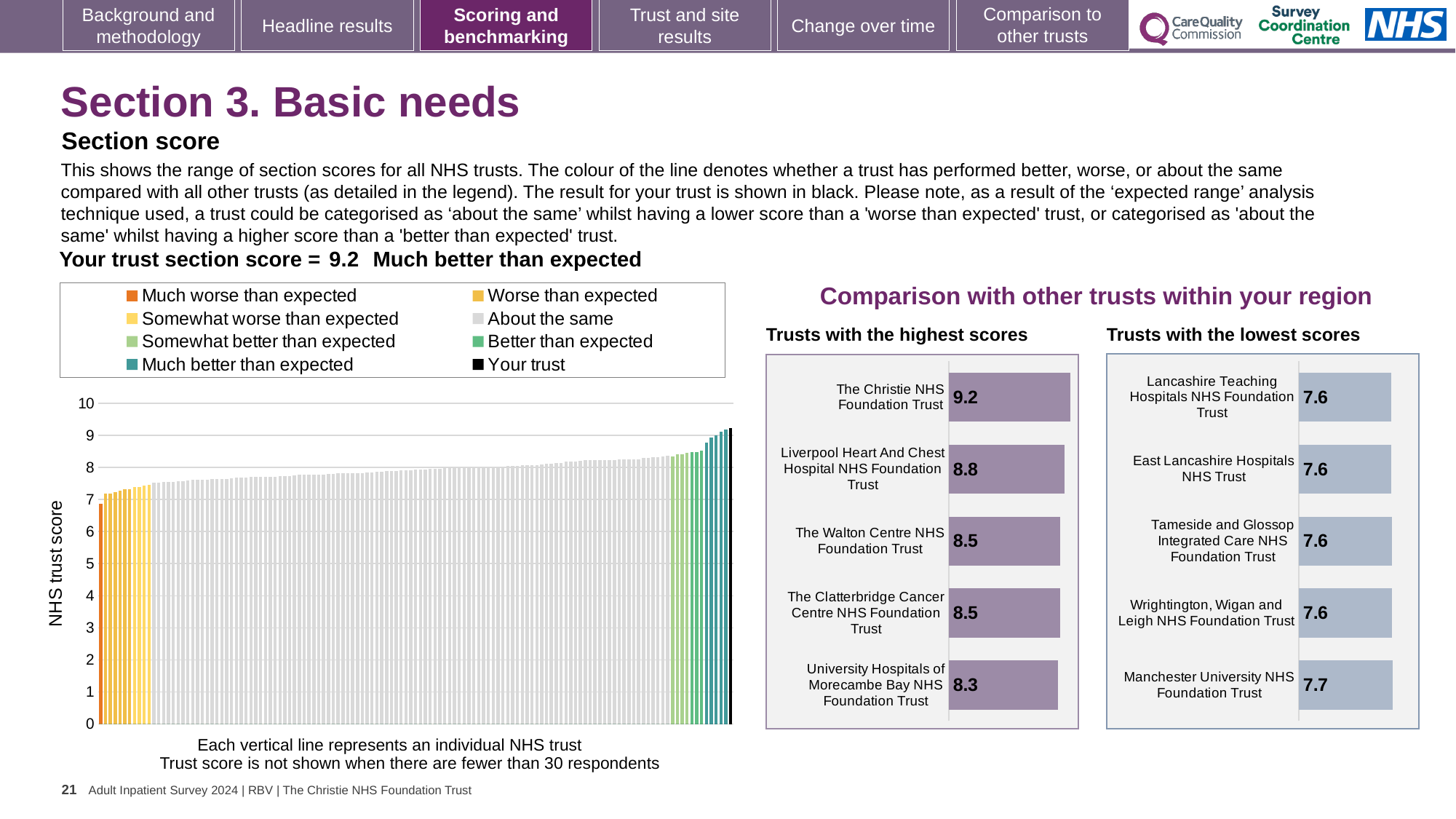
In the 'NHS trust score' chart on the left, do the bar heights rise or fall from left to right? Rise What kind of chart is the large 'NHS trust score' chart on the left of the slide? Bar chart In the 'Trusts with the highest scores' chart, which has the larger score: The Walton Centre NHS Foundation Trust or Liverpool Heart And Chest Hospital NHS Foundation Trust? Liverpool Heart And Chest Hospital NHS Foundation Trust In the 'Trusts with the lowest scores' chart, which trust has the highest score? Manchester University NHS Foundation Trust In the 'Trusts with the lowest scores' chart, what is the score for Manchester University NHS Foundation Trust? 7.7 In the 'NHS trust score' chart on the left, is the value for the black 'Your trust' bar greater or less than 9? greater How many trusts are shown in the 'Trusts with the highest scores' chart? 5 How many trusts are shown in the 'Trusts with the lowest scores' chart? 5 In the 'Trusts with the highest scores' chart, what is the score for The Christie NHS Foundation Trust? 9.2 In the 'Trusts with the highest scores' chart, what is the difference between the scores of The Christie NHS Foundation Trust and University Hospitals of Morecambe Bay NHS Foundation Trust? 0.9 In the 'Trusts with the highest scores' chart, what is the score for Liverpool Heart And Chest Hospital NHS Foundation Trust? 8.8 How many entries does the legend of the 'NHS trust score' chart on the left list? 8